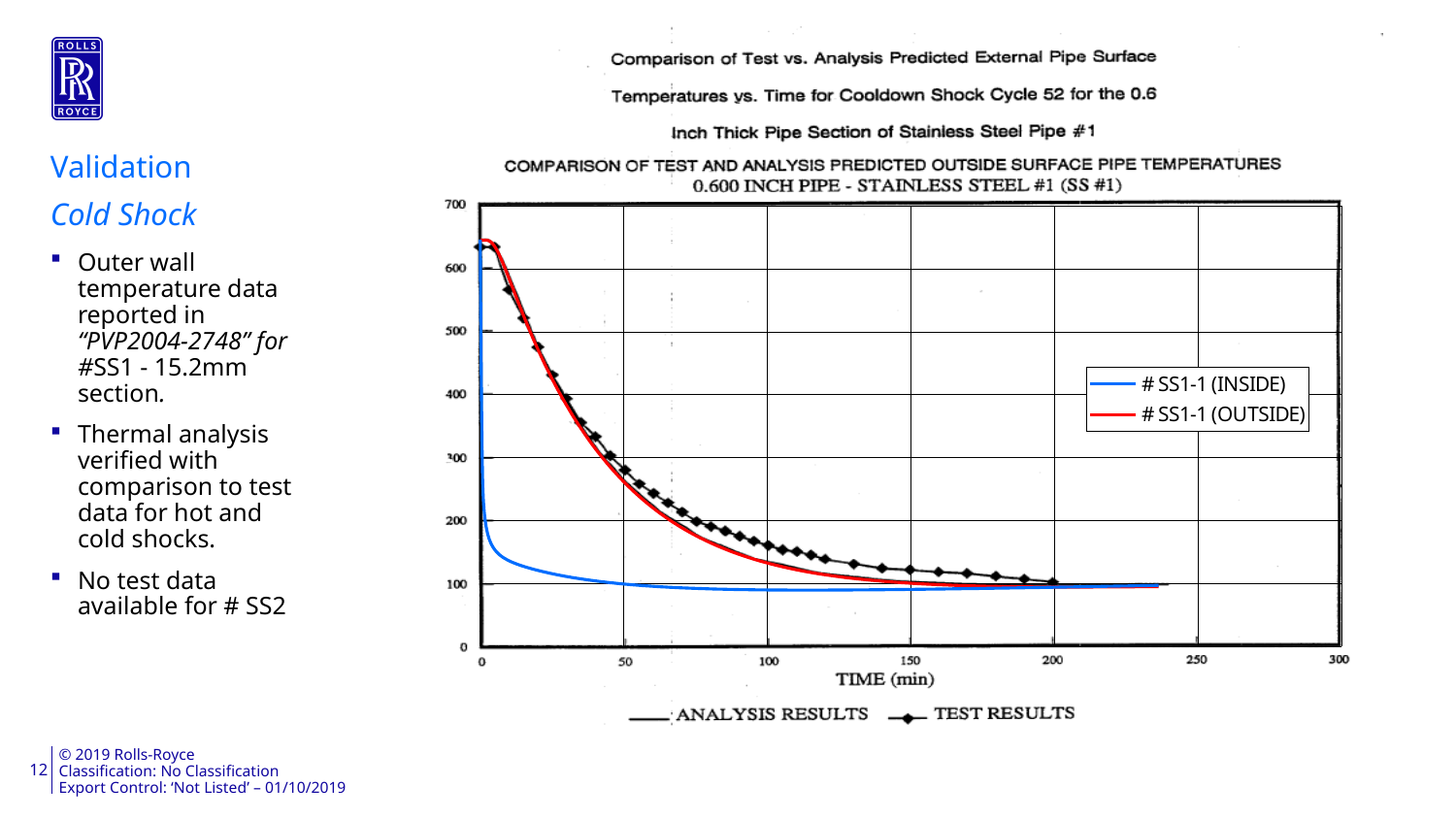
At time 50, which series has the larger value, # SS1-1 (INSIDE) or # SS1-1 (OUTSIDE)? # SS1-1 (OUTSIDE) What is the highest value shown on the x axis of the chart? 300 Do the values of the # SS1-1 (OUTSIDE) series rise or fall as time increases? fall Is the value of the # SS1-1 (OUTSIDE) series at time 0 greater or less than 600? greater What is the label of the x axis of the chart? TIME (min) Is the value of the # SS1-1 (INSIDE) series at time 25 greater or less than 200? less How many series does the chart legend list? 2 What kind of chart is shown on the slide? line chart At time 100, which series has the larger value, # SS1-1 (INSIDE) or # SS1-1 (OUTSIDE)? # SS1-1 (OUTSIDE) Do the values of the # SS1-1 (INSIDE) series rise or fall as time increases? fall Is the value of the # SS1-1 (OUTSIDE) series at time 100 greater or less than 200? less What are the two series named in the chart legend? # SS1-1 (INSIDE) and # SS1-1 (OUTSIDE)